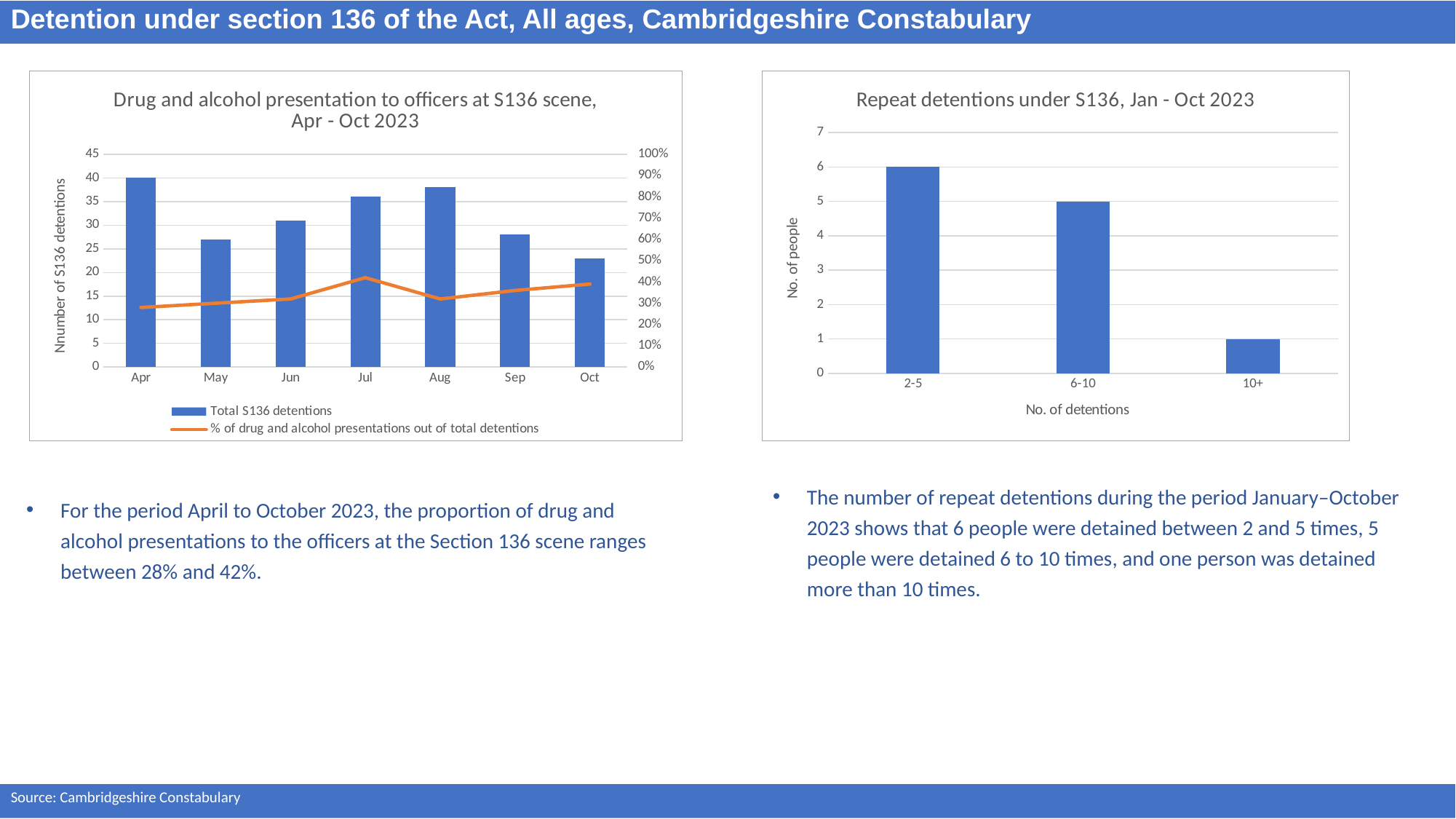
In the chart 'Drug and alcohol presentation to officers at S136 scene, Apr - Oct 2023', does the percentage line rise or fall from Apr to Jul? Rises How many series does the legend of the chart 'Drug and alcohol presentation to officers at S136 scene, Apr - Oct 2023' list? 2 In the chart 'Repeat detentions under S136, Jan - Oct 2023', how many categories are shown on the x axis? 3 What type of chart is 'Repeat detentions under S136, Jan - Oct 2023'? Bar chart In the chart 'Repeat detentions under S136, Jan - Oct 2023', which category has the highest number of people? 2-5 In the chart 'Repeat detentions under S136, Jan - Oct 2023', what is the difference between the 6-10 and 10+ categories? 4 In the chart 'Drug and alcohol presentation to officers at S136 scene, Apr - Oct 2023', which month has the lowest total S136 detentions? Oct In the chart 'Repeat detentions under S136, Jan - Oct 2023', what is the value for the 10+ category? 1 In the chart 'Drug and alcohol presentation to officers at S136 scene, Apr - Oct 2023', which month has more total S136 detentions, Aug or Sep? Aug In the chart 'Repeat detentions under S136, Jan - Oct 2023', how many people were detained 2-5 times? 6 In the chart 'Drug and alcohol presentation to officers at S136 scene, Apr - Oct 2023', what is the total number of S136 detentions in Apr? 40 In the chart 'Drug and alcohol presentation to officers at S136 scene, Apr - Oct 2023', is the total S136 detentions for May greater or less than 30? less